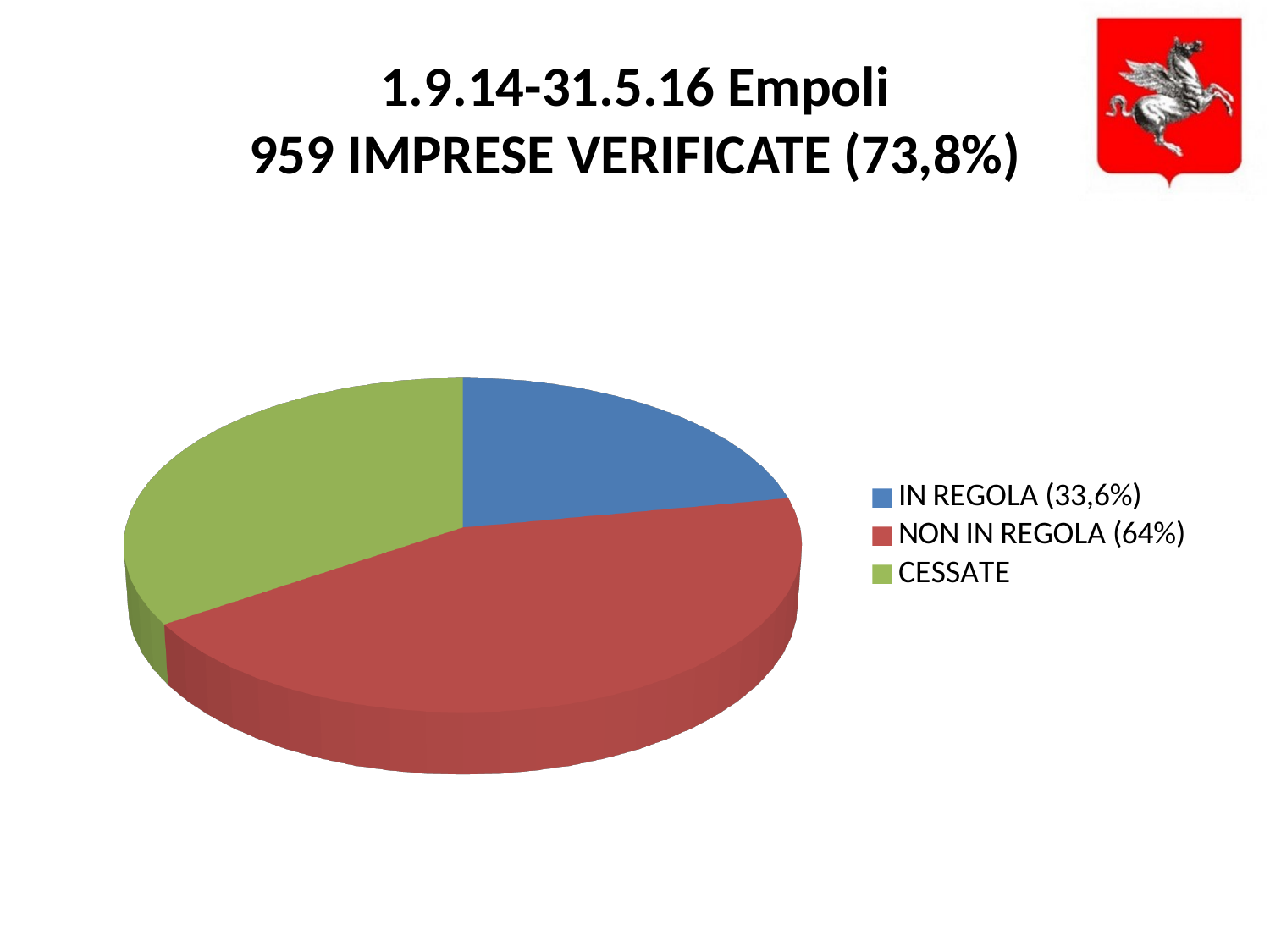
How many entries does the legend of the pie chart list? 3 Which category has the smallest slice of the pie chart? IN REGOLA (33,6%) What kind of chart is shown on the slide? pie chart How many slices does the pie chart have? 3 What is the title of the slide containing the pie chart? 1.9.14-31.5.16 Empoli 959 IMPRESE VERIFICATE (73,8%) Which slice is larger, NON IN REGOLA or CESSATE? NON IN REGOLA Which colour represents CESSATE in the pie chart? green Which slice is larger, CESSATE or IN REGOLA? CESSATE Which category has the largest slice of the pie chart? NON IN REGOLA (64%)